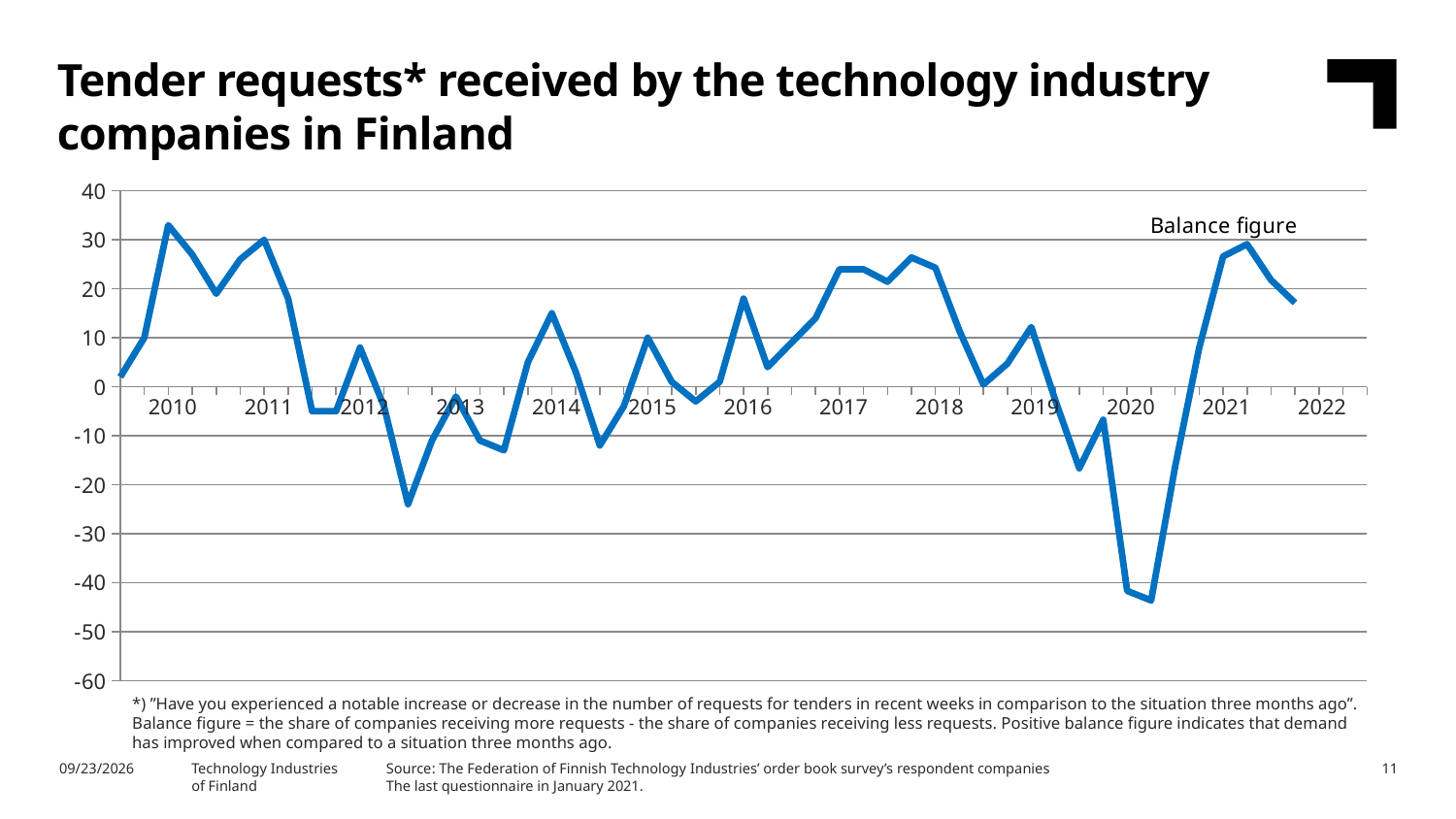
How many year labels are shown along the x axis? 13 Is the peak value of the line in 2010 greater or less than 20? greater What label is shown in the upper right of the plot area describing the plotted measure? Balance figure What is the title of the chart on the slide? Tender requests* received by the technology industry companies in Finland Does the line rise or fall between its low point in 2020 and its peak in 2021? rise What kind of chart is shown on the slide? line chart Does the line rise or fall from its 2021 peak to the last point in 2022? fall In which year does the line reach its lowest point? 2020 Is the value at the start of 2012 greater or less than 0? less Is the value at the 2021 peak larger or smaller than the value at the 2020 low? larger Is the lowest value of the line, in 2020, greater or less than -30? less